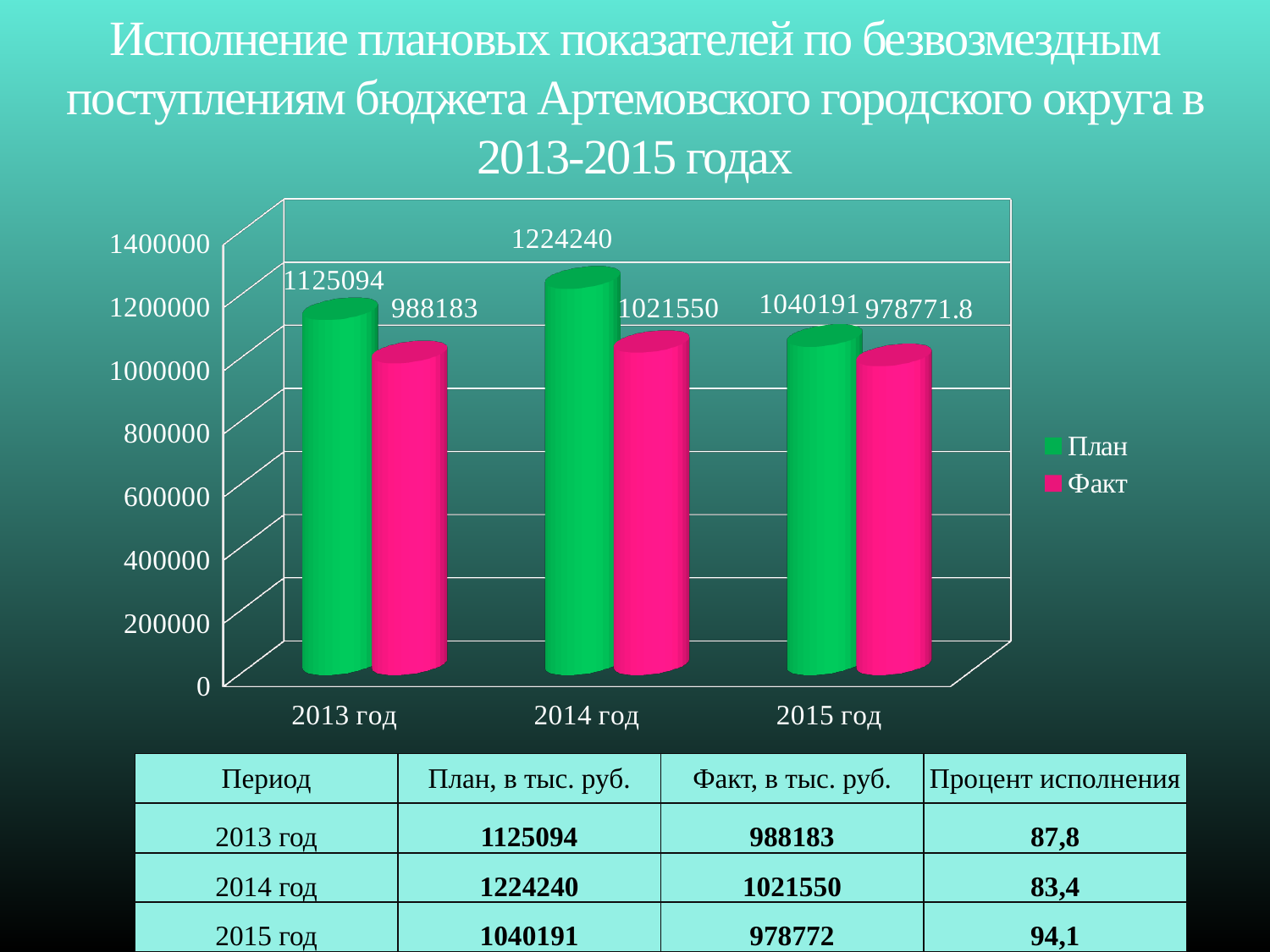
What is the value of Факт for 2015 год as labelled on the chart? 978771.8 What is the value of План for 2015 год? 1040191 What is the difference between План and Факт for 2013 год? 136911 How many years are shown on the x axis of the chart? 3 Is the value of Факт for 2014 год greater or less than 1000000? greater What is the value of План for 2014 год? 1224240 Which year has the lowest Факт value? 2015 год Which year has the highest План value? 2014 год What is the value of Факт for 2013 год? 988183 Which is larger for 2014 год, План or Факт? План How many series does the legend list? 2 What kind of chart is shown on the slide? bar chart